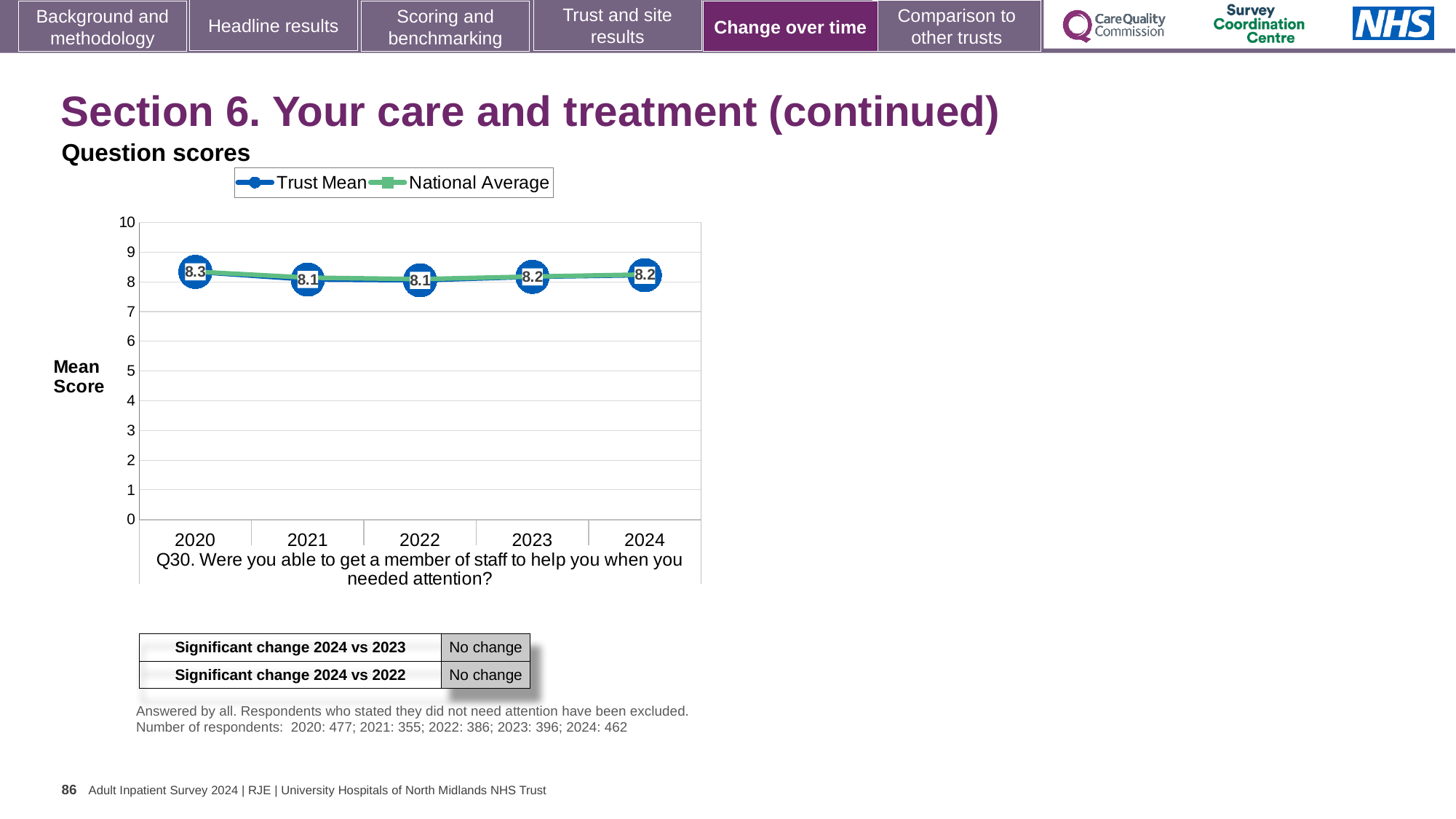
What kind of chart is shown on the slide? Line chart How many years are plotted on the x axis? 5 Does the Trust Mean score rise or fall from 2020 to 2021? Fall What is the Trust Mean score for 2022? 8.1 What is the Trust Mean score for 2024? 8.2 What is the difference between the Trust Mean scores for 2020 and 2021? 0.2 What is the Trust Mean score for 2020? 8.3 Which year has the larger Trust Mean score, 2020 or 2021? 2020 Is the National Average value for 2023 greater or less than 5? greater How many series does the legend list? 2 In which year is the Trust Mean score highest? 2020 What is the lowest Trust Mean score shown on the chart? 8.1